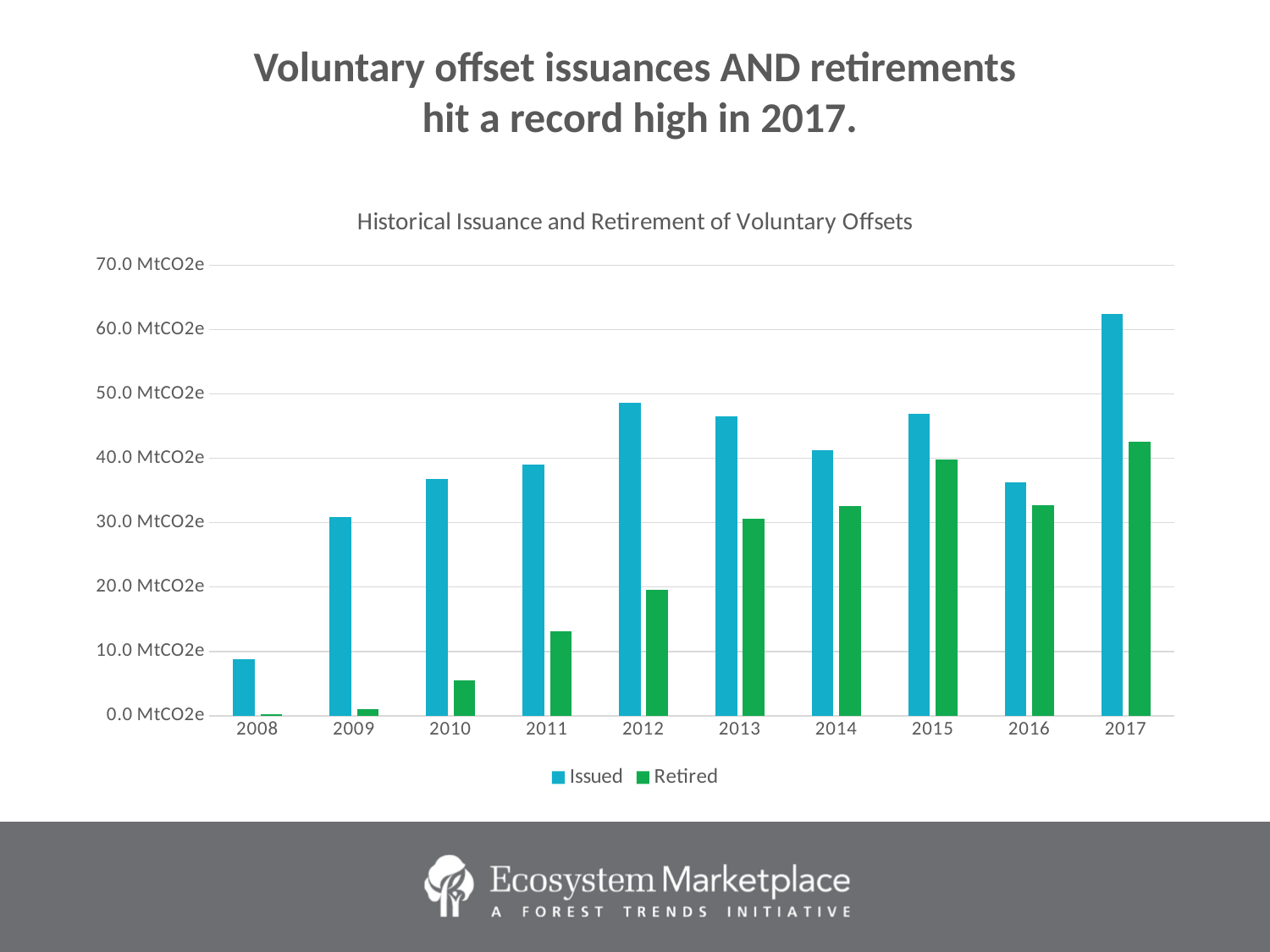
In 2014, which is larger, the Issued value or the Retired value? Issued Is the Issued value for 2008 greater or less than 10.0 MtCO2e? less Which year has the lowest Retired value? 2008 Which year has the highest Issued value? 2017 Is the Issued value for 2017 greater or less than 60.0 MtCO2e? greater How many series does the legend list? 2 What is the title of the chart? Historical Issuance and Retirement of Voluntary Offsets Which year has the highest Retired value? 2017 What kind of chart is shown on the slide? bar chart Does the Retired value rise or fall from 2008 to 2015? rise How many years are shown on the x axis? 10 Is the Retired value for 2011 greater or less than 10.0 MtCO2e? greater